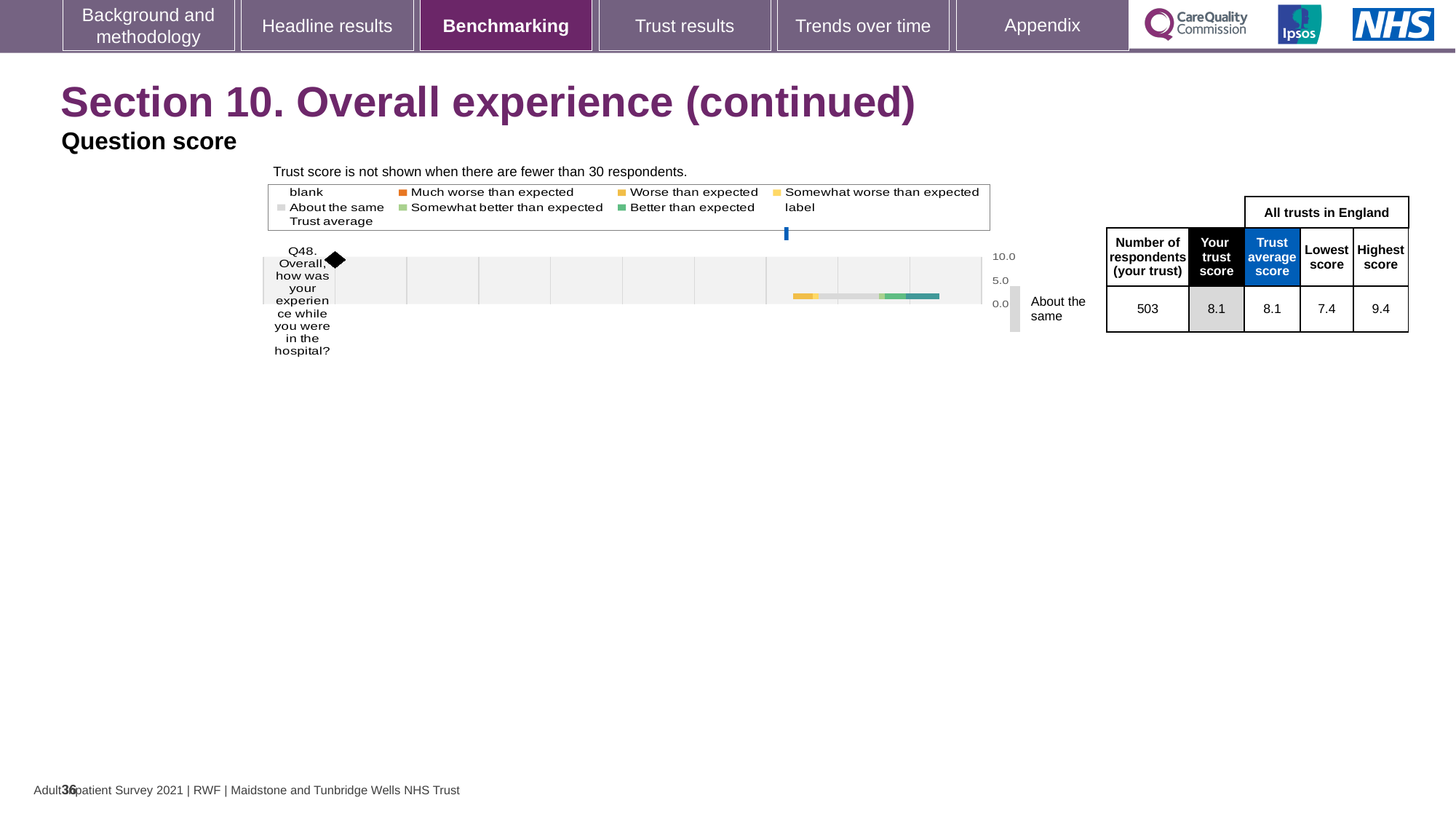
How many respondents from the trust answered Q48? 503 What is the trust average score for Q48 across all trusts in England? 8.1 What is the difference between the highest score and the lowest score for Q48 across all trusts in England? 2.0 What kind of chart is used to show the Q48 benchmarking result? bar chart Is the trust score for Q48 greater or less than 5.0 on the chart's axis? greater Which is larger for Q48: the highest score in England or the trust's own score? Highest score What is the maximum value shown on the chart's axis? 10.0 What benchmark category label is shown next to the Q48 bar? About the same What is the highest score for Q48 among all trusts in England? 9.4 What is the lowest score for Q48 among all trusts in England? 7.4 What is the trust score for Q48 shown in the 'Your trust score' column? 8.1 How many questions (categories) are plotted on the chart? 1